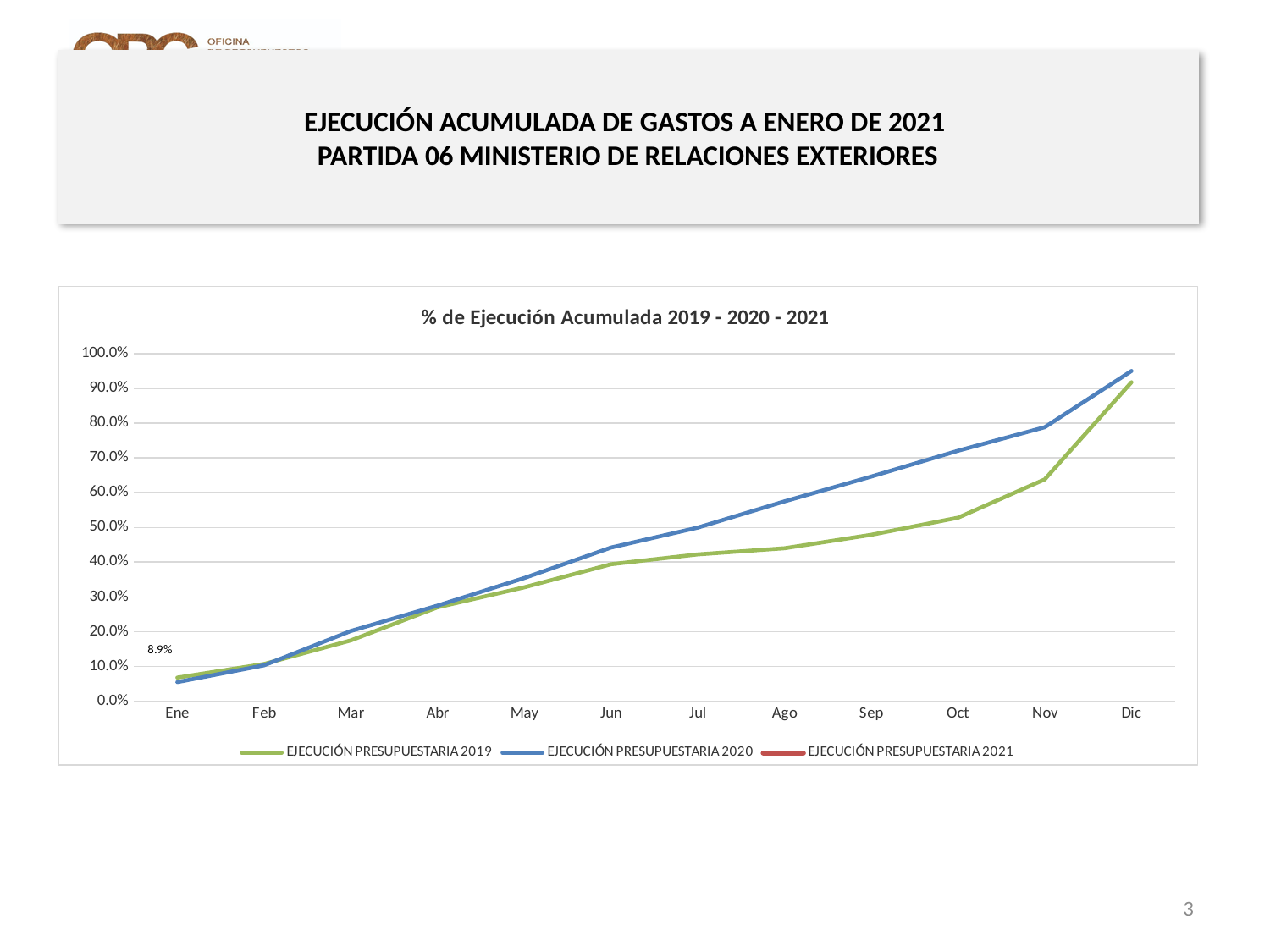
In Oct, which series has the higher value, EJECUCIÓN PRESUPUESTARIA 2019 or EJECUCIÓN PRESUPUESTARIA 2020? EJECUCIÓN PRESUPUESTARIA 2020 Is the value for EJECUCIÓN PRESUPUESTARIA 2019 in Oct greater or less than 50.0%? greater Does the EJECUCIÓN PRESUPUESTARIA 2020 line rise or fall from Ene to Dic? rise What kind of chart is shown on the slide? line chart Is the value for EJECUCIÓN PRESUPUESTARIA 2020 in Dic greater or less than 90.0%? greater How many series does the chart legend list? 3 Is the value for EJECUCIÓN PRESUPUESTARIA 2019 in Sep greater or less than 50.0%? less What is the title of the chart? % de Ejecución Acumulada 2019 - 2020 - 2021 What value is printed as a data label near Ene on the chart? 8.9% How many months are shown along the x axis of the chart? 12 In which month does the EJECUCIÓN PRESUPUESTARIA 2019 series reach its highest value? Dic